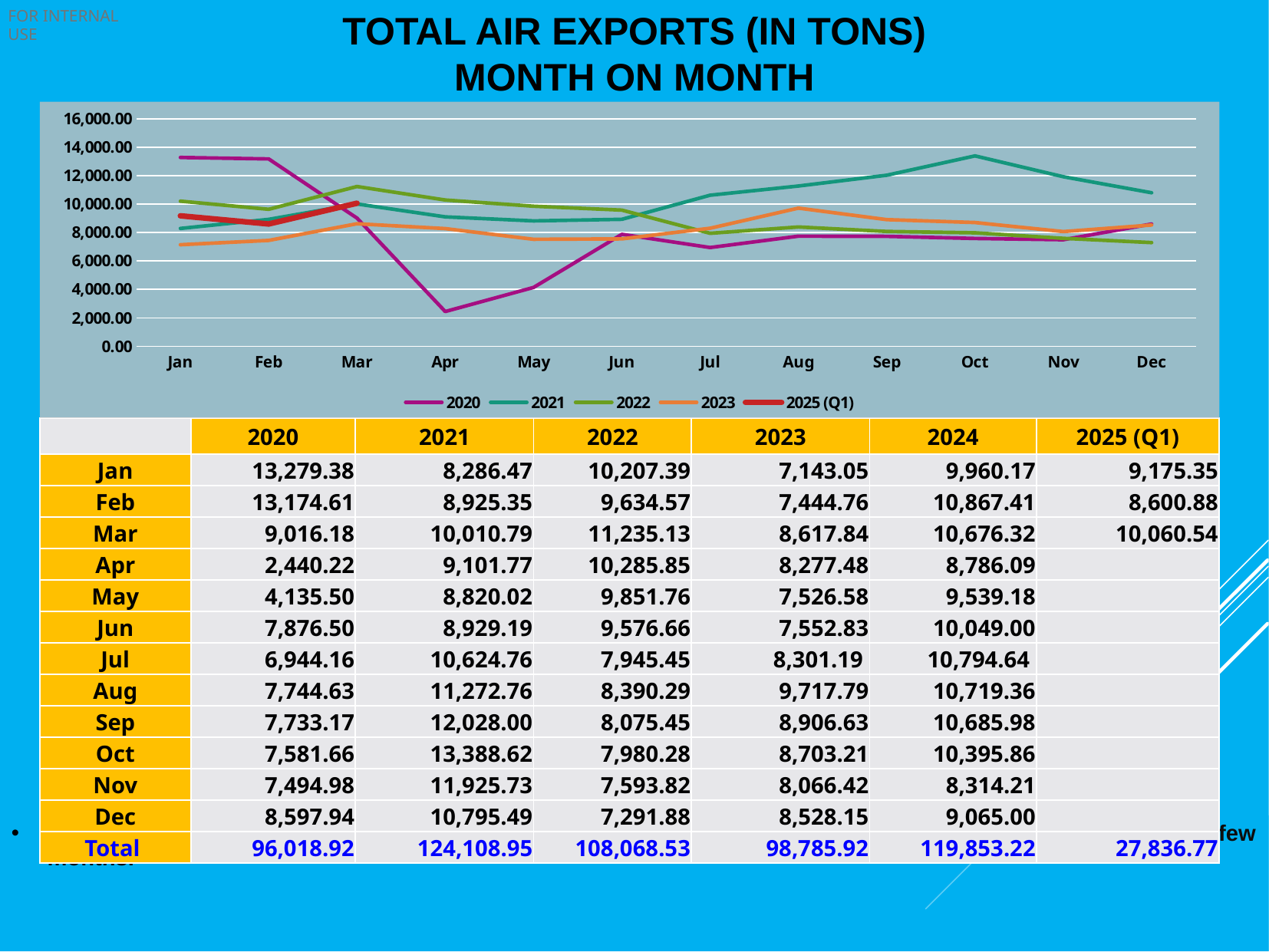
What is the value for Jan in the 2020 series? 13,279.38 How many series does the chart legend list? 5 Which year shown in the table is not listed in the chart legend? 2024 Which is larger in Jan: the 2020 value or the 2022 value? 2020 Does the 2020 series rise or fall from Feb to Apr? Fall In which month does the 2020 series reach its lowest value? Apr What is the difference between the Mar and Jan values of the 2025 (Q1) series? 885.19 What is the value for Mar in the 2025 (Q1) series? 10,060.54 In which month does the 2021 series reach its highest value? Oct What kind of chart is shown on the slide? Line chart How many months are plotted along the x axis of the chart? 12 Is the value for Apr in the 2020 series greater or less than 4,000.00? less